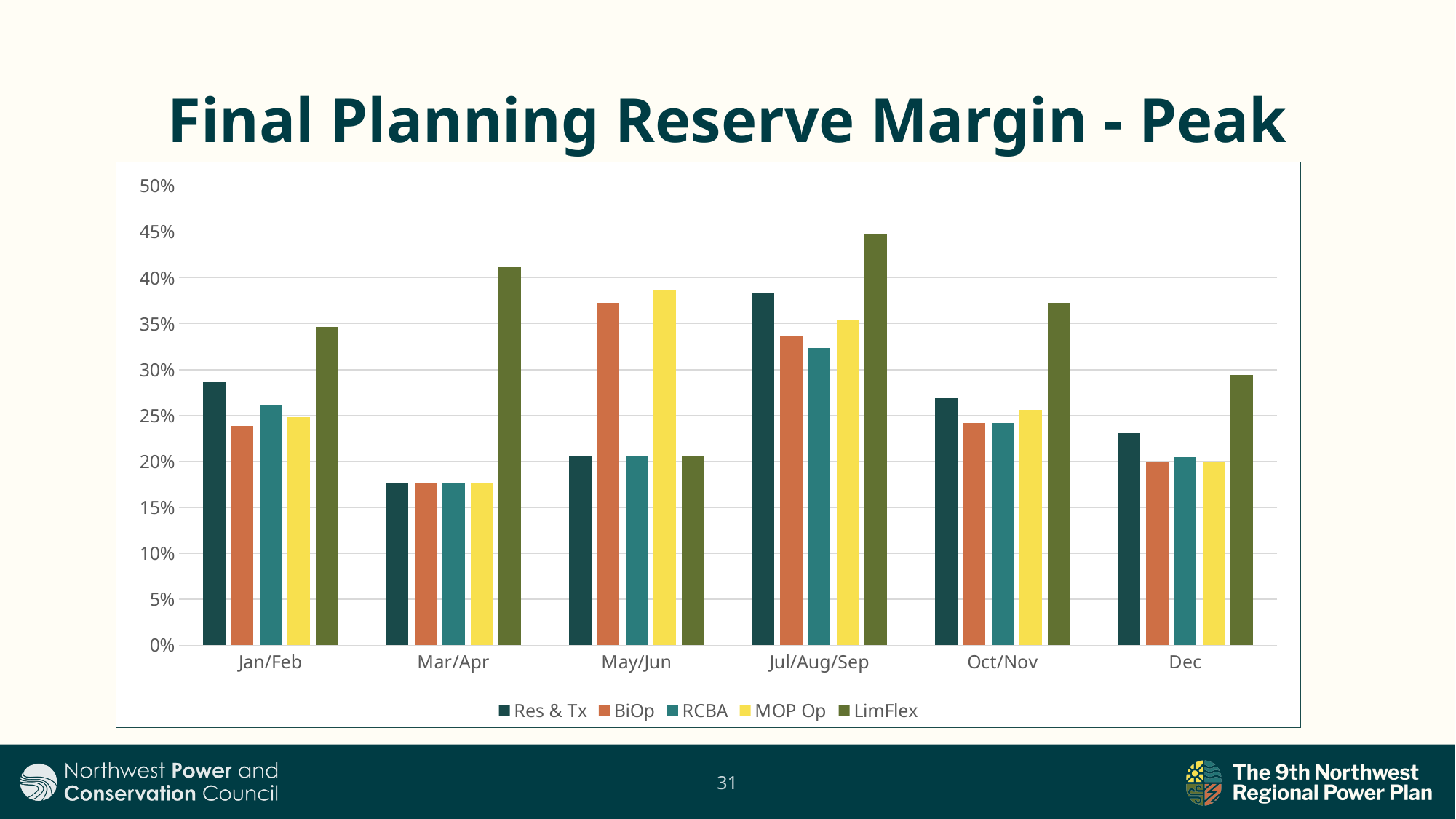
What is the title of the chart? Final Planning Reserve Margin - Peak Is the Res & Tx value for Jul/Aug/Sep greater or less than 35%? greater What kind of chart is shown on the slide? bar chart In which period is the LimFlex value highest? Jul/Aug/Sep In Jan/Feb, which is larger: the Res & Tx value or the BiOp value? Res & Tx In Jul/Aug/Sep, which series has the highest value? LimFlex Is the BiOp value for Dec greater or less than 25%? less In which period is the LimFlex value lowest? May/Jun Is the LimFlex value for Mar/Apr greater or less than 40%? greater How many time-period categories are shown on the x axis? 6 How many series does the legend list? 5 In May/Jun, which is larger: the BiOp value or the Res & Tx value? BiOp